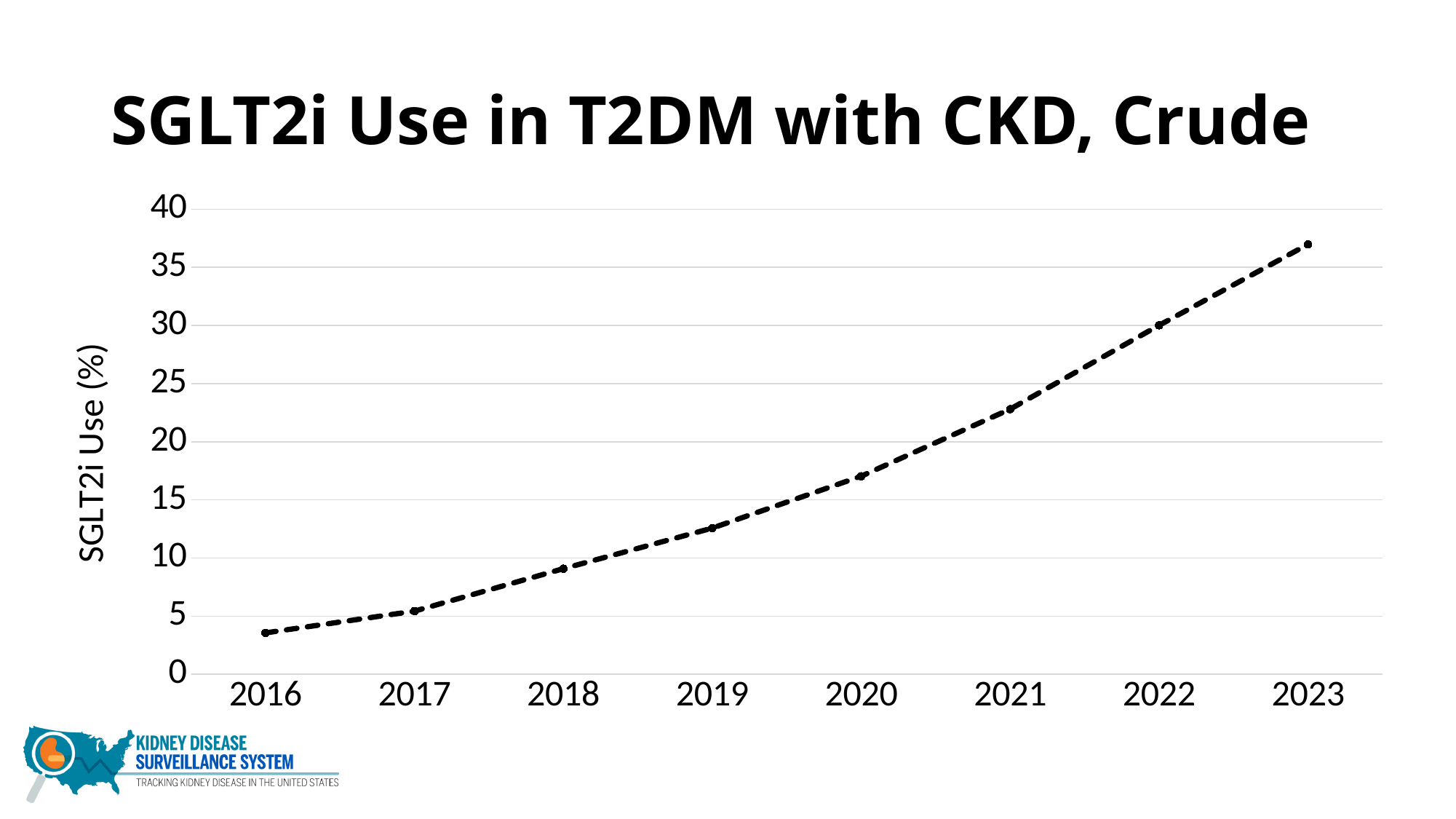
How many years are plotted on the x axis? 8 Is the value for 2016 greater or less than 5? less Which year has the highest SGLT2i use? 2023 What type of chart is shown on the slide? line chart What is the label of the y axis? SGLT2i Use (%) Is the value for 2020 greater or less than 15? greater Does SGLT2i use rise or fall from 2016 to 2023? rise Which year has a higher SGLT2i use, 2019 or 2021? 2021 Is the value for 2018 greater or less than 10? less What is the title of the chart? SGLT2i Use in T2DM with CKD, Crude Which year has the lowest SGLT2i use? 2016